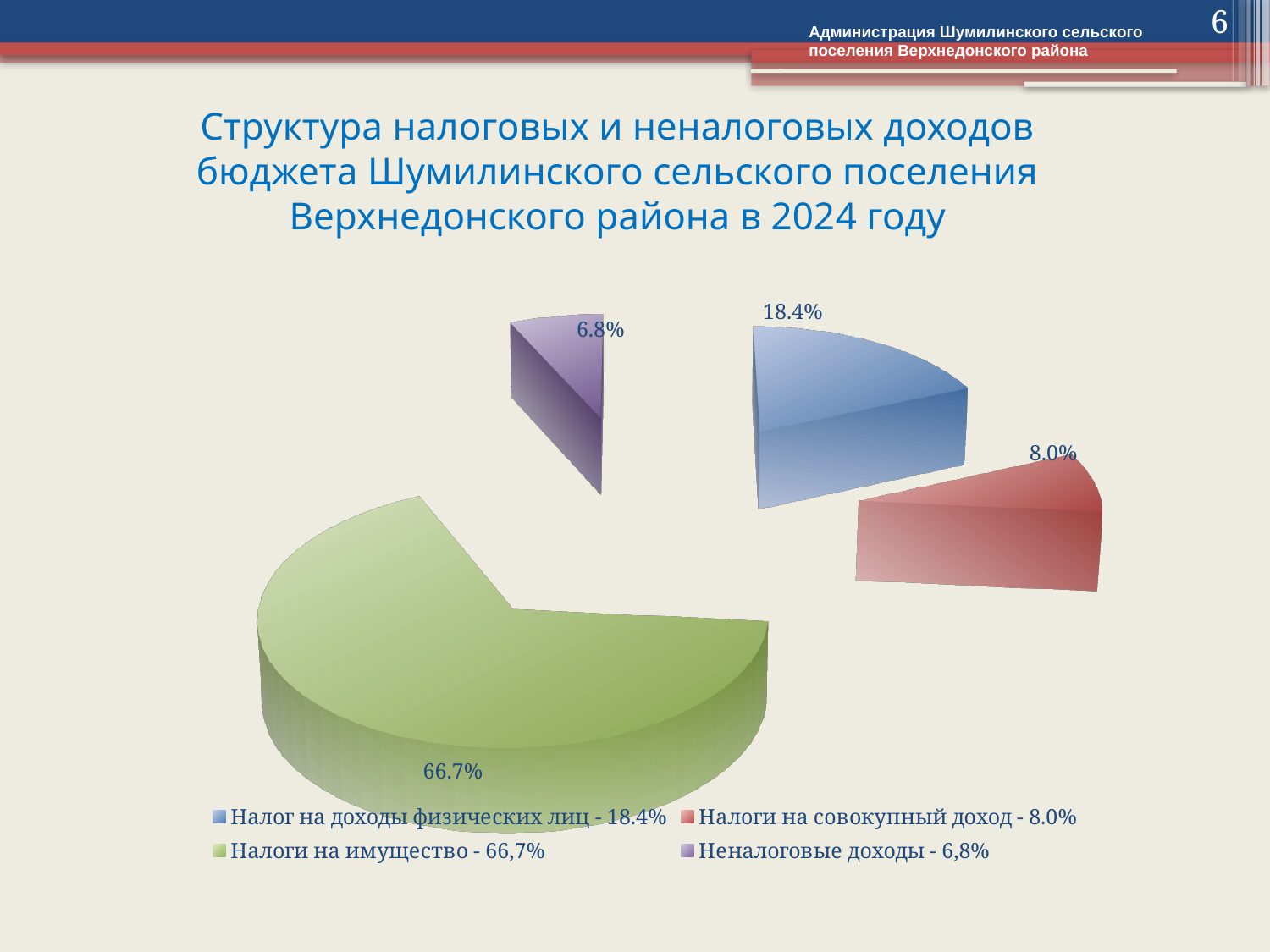
What is the value shown for "Налоги на совокупный доход"? 8.0% What colour is the slice for "Налоги на имущество"? Green How many slices does the pie chart have? 4 What is the value shown for "Неналоговые доходы"? 6.8% What is the difference in percentage points between "Налоги на имущество" and "Налог на доходы физических лиц"? 48.3 Which category has the smallest slice of the pie? Неналоговые доходы What is the difference in percentage points between "Налог на доходы физических лиц" and "Налоги на совокупный доход"? 10.4 What share of the pie does "Налоги на имущество" represent? 66.7% What is the value shown for "Налог на доходы физических лиц"? 18.4% Which is larger: the slice for "Налоги на совокупный доход" or the slice for "Неналоговые доходы"? Налоги на совокупный доход Which category has the largest slice of the pie? Налоги на имущество What type of chart is shown on the slide? Pie chart